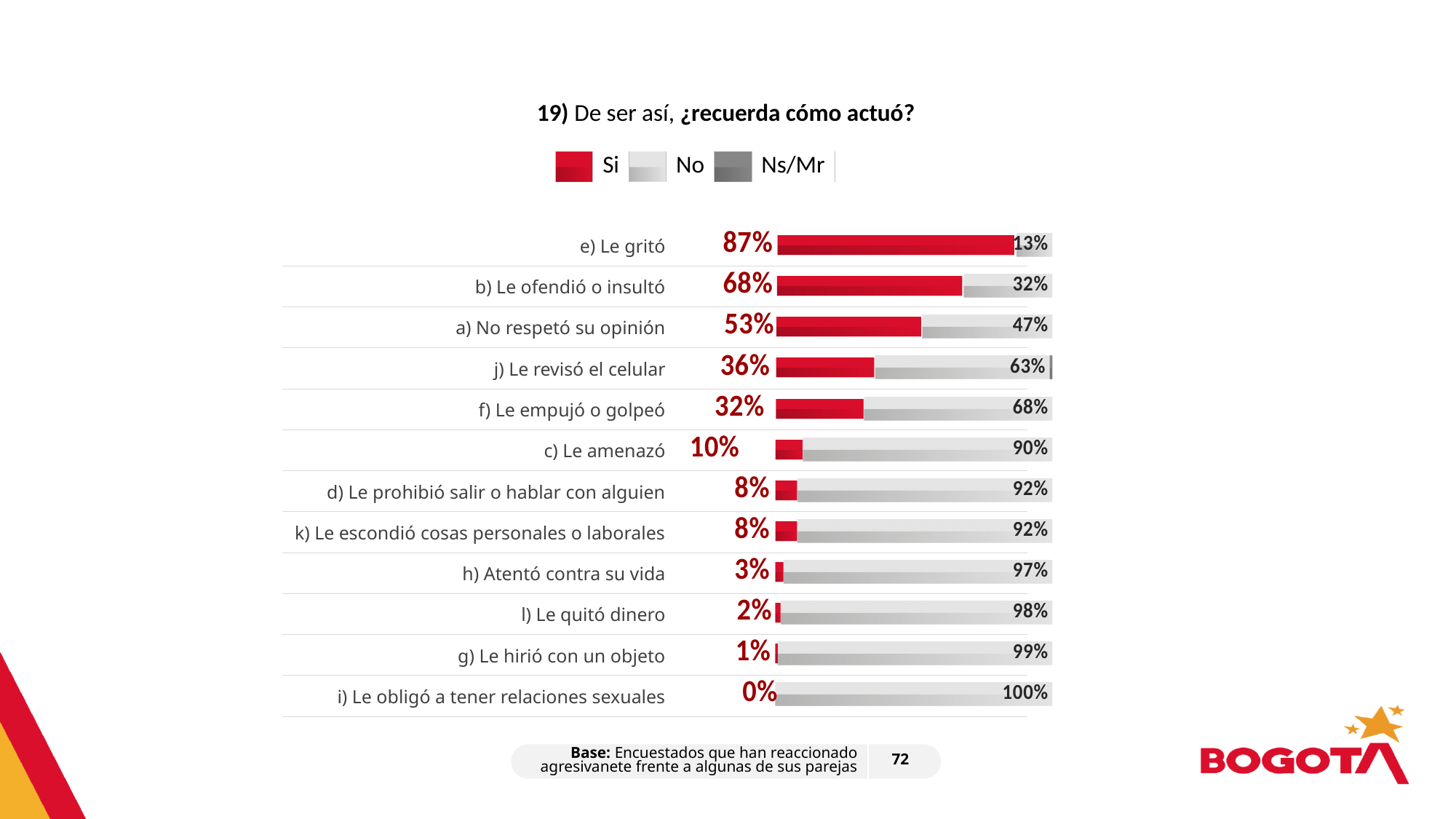
What is the base (number of respondents) shown below the chart? 72 What is the "No" value for "a) No respetó su opinión"? 47% How many series does the legend list? 3 What percentage answered "Si" for "f) Le empujó o golpeó"? 32% How many categories are shown in the chart? 12 What kind of chart is shown on the slide? Stacked bar chart Which has a larger "Si" value, "c) Le amenazó" or "f) Le empujó o golpeó"? f) Le empujó o golpeó What is the "No" value for "j) Le revisó el celular"? 63% Which category has the lowest "Si" percentage? i) Le obligó a tener relaciones sexuales What percentage answered "Si" for "e) Le gritó"? 87% Which category has the highest "Si" percentage? e) Le gritó What is the difference between the "Si" values for "e) Le gritó" and "b) Le ofendió o insultó"? 19%